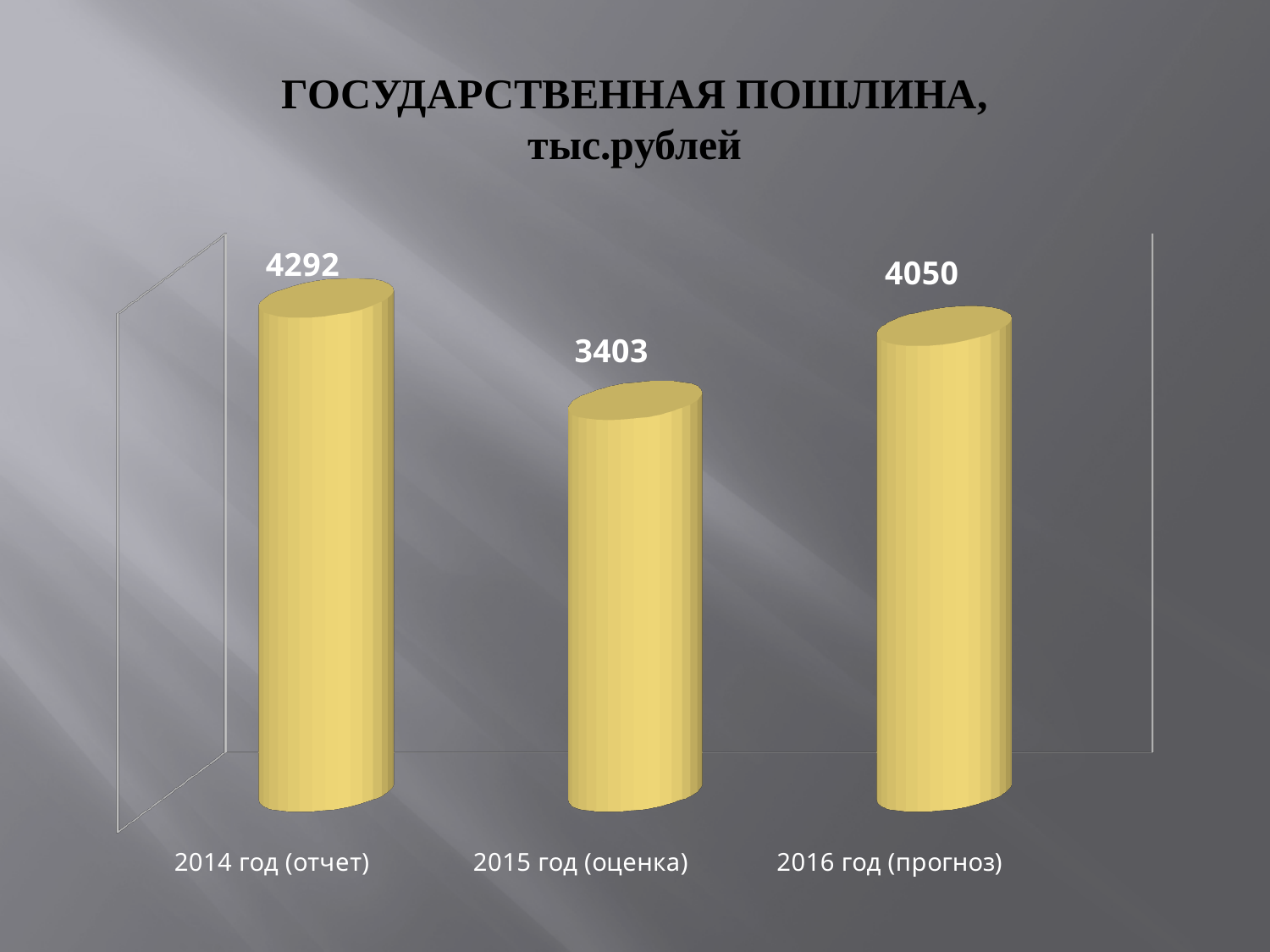
Which is larger, the value for 2014 год (отчет) or the value for 2016 год (прогноз)? 2014 год (отчет) What is the title of the chart? ГОСУДАРСТВЕННАЯ ПОШЛИНА, тыс.рублей What kind of chart is shown on the slide? bar chart How many categories are shown in the chart? 3 What is the value for 2016 год (прогноз)? 4050 Which category has the lowest value? 2015 год (оценка) What is the difference between the values for 2014 год (отчет) and 2016 год (прогноз)? 242 Which category has the highest value? 2014 год (отчет) What is the value for 2015 год (оценка)? 3403 What is the difference between the values for 2016 год (прогноз) and 2015 год (оценка)? 647 What is the difference between the values for 2014 год (отчет) and 2015 год (оценка)? 889 What is the value for 2014 год (отчет)? 4292